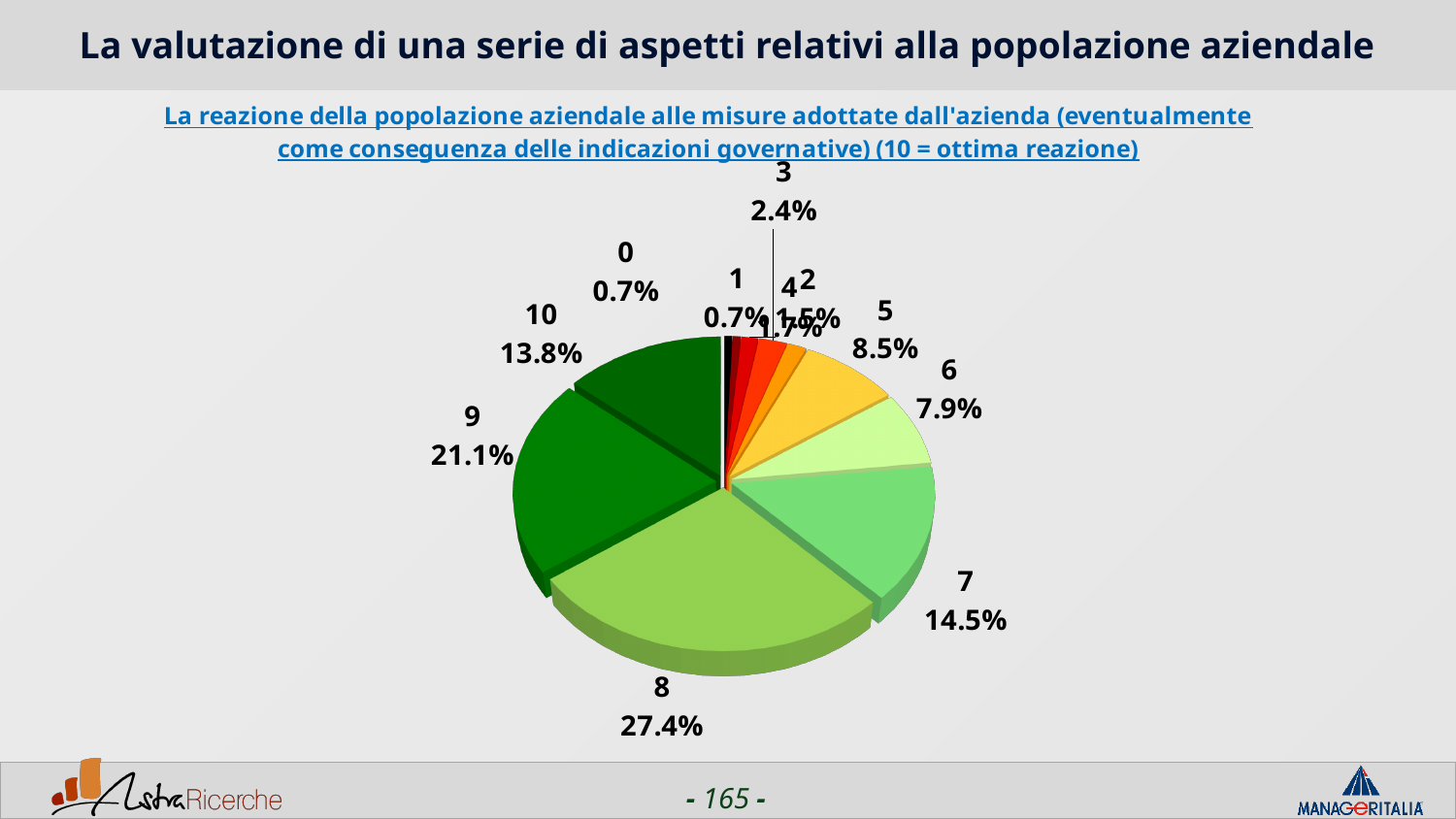
Which slice is larger, rating 5 or rating 6? 5 According to the chart subtitle, what does a rating of 10 mean? ottima reazione What percentage is shown for the rating 5? 8.5% What type of chart is shown on the slide? Pie chart How many slices (rating categories) does the pie chart have? 11 What percentage is shown for the rating 3? 2.4% What percentage is shown for the rating 7? 14.5% What share of the pie does the rating 8 represent? 27.4% What percentage is shown for the rating 10? 13.8% What percentage is shown for the rating 9? 21.1% What is the difference in percentage points between the slices for rating 8 and rating 9? 6.3% Which rating has the largest slice of the pie? 8